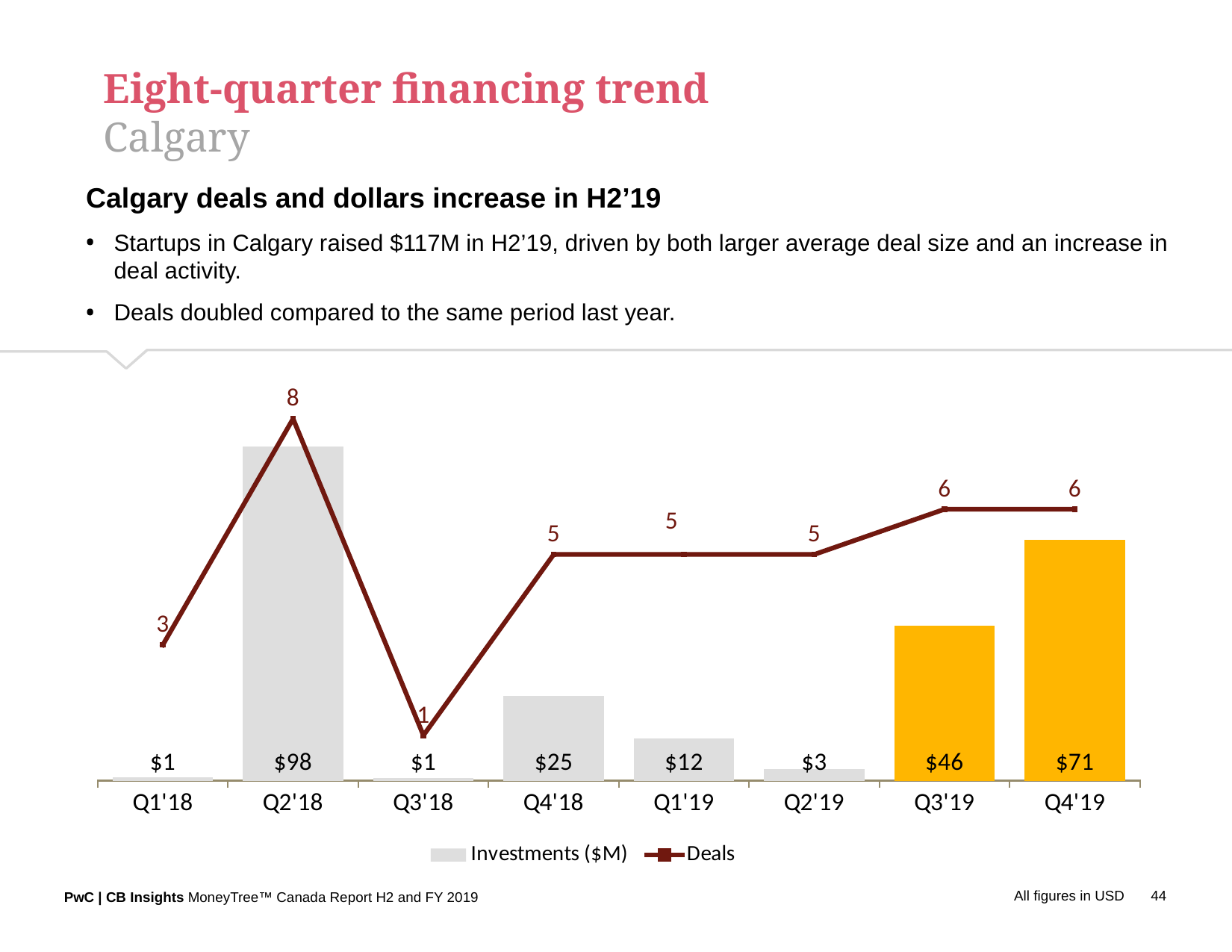
Which quarter has the highest Investments ($M) value? Q2'18 What is the Investments ($M) value for Q2'18? $98 Which quarter has more deals, Q4'18 or Q3'19? Q3'19 What kind of chart is used to show the Investments ($M) series? Bar chart How many deals were recorded in Q3'18? 1 Which quarter has the lowest number of deals? Q3'18 What is the difference in Investments ($M) between Q4'19 and Q3'19? $25 What are the two series named in the legend? Investments ($M) and Deals How many deals were recorded in Q2'18? 8 What is the Investments ($M) value for Q4'19? $71 How many series does the legend list? 2 How many quarters are shown on the x axis? 8